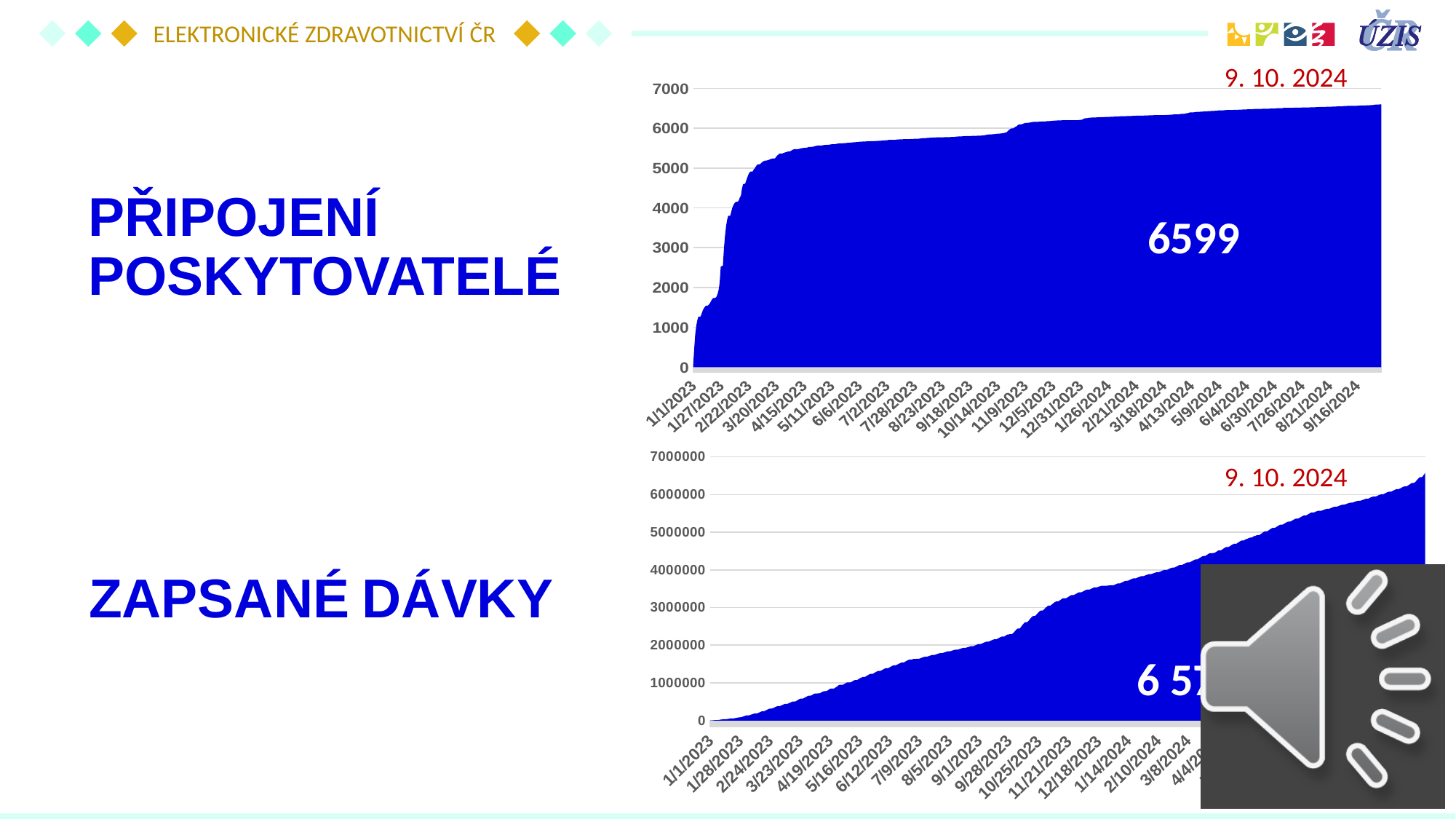
In the bottom chart (ZAPSANÉ DÁVKY), is the value at 3/23/2023 greater or less than 1000000? less What type of chart is the top chart (PŘIPOJENÍ POSKYTOVATELÉ)? area chart In the bottom chart (ZAPSANÉ DÁVKY), do the values rise or fall along the x axis over time? rise What type of chart is the bottom chart (ZAPSANÉ DÁVKY)? area chart In the top chart (PŘIPOJENÍ POSKYTOVATELÉ), what value is printed on the chart as the latest number of connected providers? 6599 In the top chart (PŘIPOJENÍ POSKYTOVATELÉ), do the values rise or fall along the x axis from 1/1/2023 to 9/16/2024? rise In the top chart (PŘIPOJENÍ POSKYTOVATELÉ), is the value at 6/6/2023 greater or less than 5000? greater In the top chart (PŘIPOJENÍ POSKYTOVATELÉ), is the value at 9/16/2024 greater or less than 6000? greater In the top chart (PŘIPOJENÍ POSKYTOVATELÉ), what date is shown in red above the chart? 9. 10. 2024 In the top chart (PŘIPOJENÍ POSKYTOVATELÉ), what is the highest value shown on the y axis? 7000